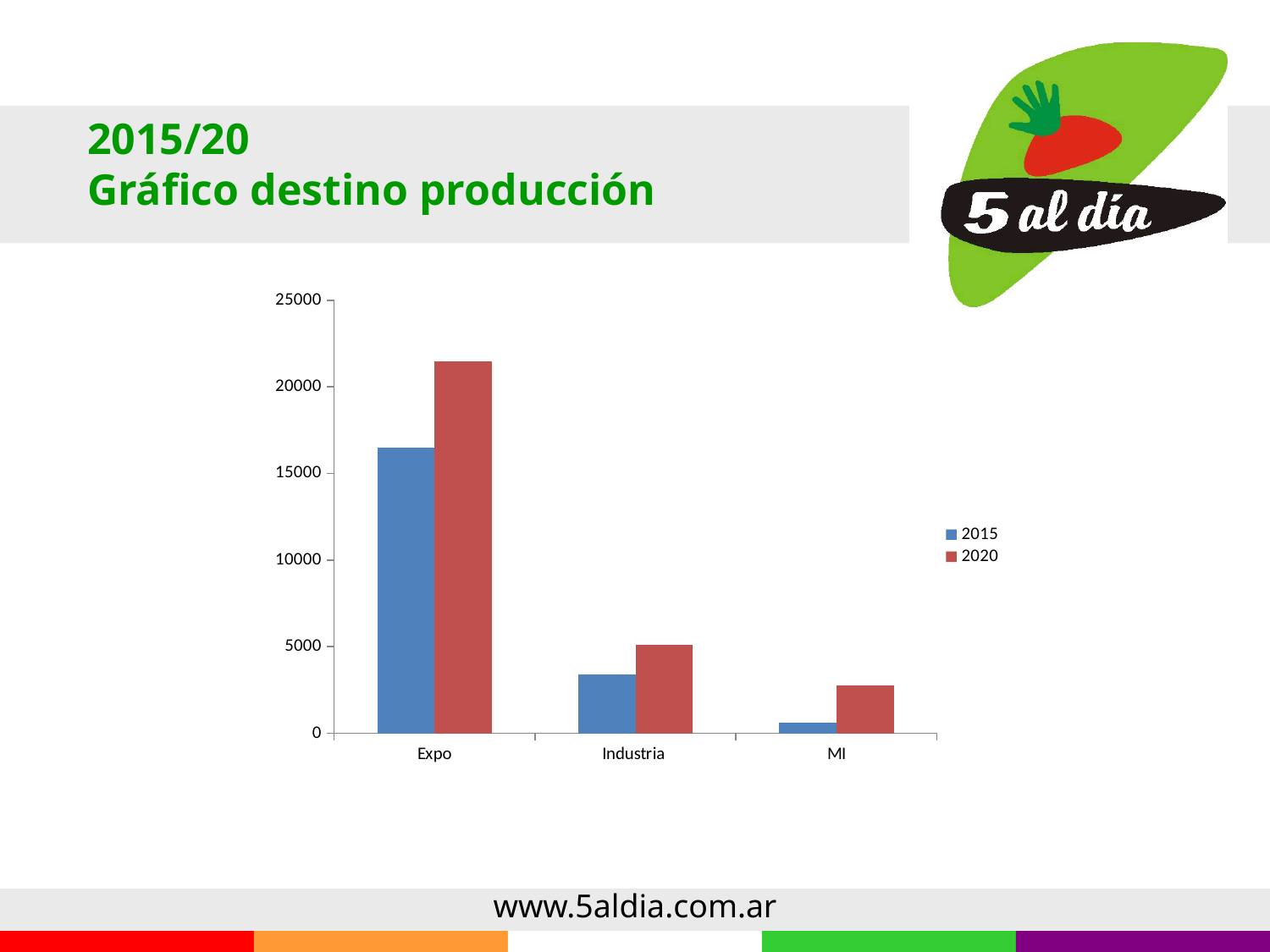
Is the value for Expo in 2015 greater or less than 15000? greater Which category has the lowest value for the 2020 series? MI Which category has the lowest value for the 2015 series? MI For Expo, which series has the larger value, 2015 or 2020? 2020 How many series does the chart's legend list? 2 For Industria, which series has the larger value, 2015 or 2020? 2020 Is the value for MI in 2020 greater or less than 5000? less Is the value for Expo in 2020 greater or less than 20000? greater What kind of chart is shown on the slide? bar chart Which series are listed in the chart's legend? 2015 and 2020 Which category has the highest value for the 2020 series? Expo How many categories are shown on the x axis of the chart? 3